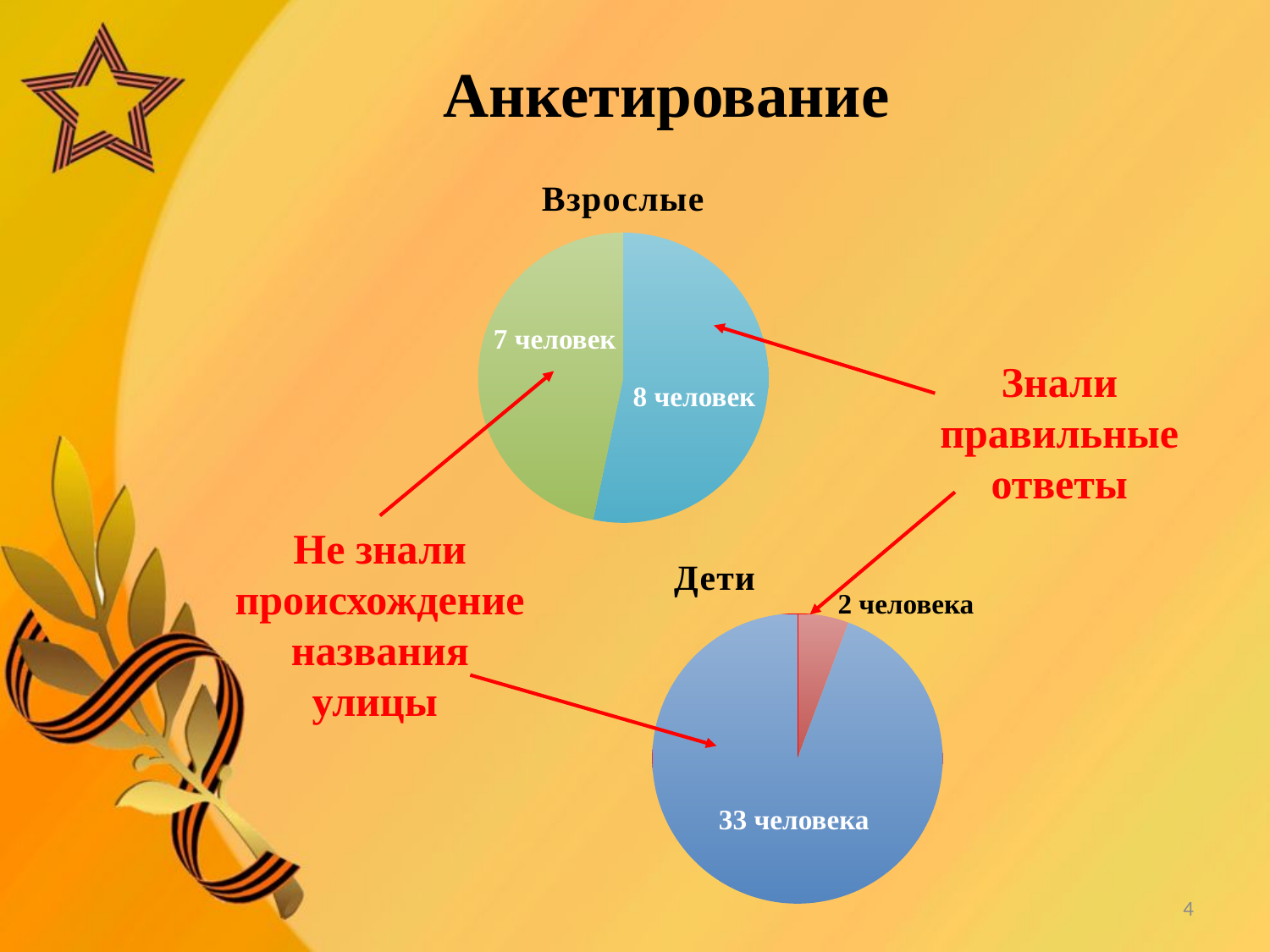
In the "Дети" chart, what is the difference between the number who did not know and the number who knew the correct answers? 31 What is the total number of adults surveyed in the "Взрослые" chart? 15 In the "Дети" chart, what colour is the slice labelled "2 человека"? Red In the "Взрослые" chart, how many people did not know the origin of the street name (Не знали происхождение названия улицы)? 7 человек What is the total number of children surveyed in the "Дети" chart? 35 In the "Взрослые" chart, which group is larger: those who knew the correct answers or those who did not know? Those who knew the correct answers (8 человек) In the "Дети" chart, how many children did not know the origin of the street name? 33 человека In the "Дети" chart, how many children knew the correct answers? 2 человека In the "Дети" chart, which slice is the largest? 33 человека (Не знали происхождение названия улицы) What kind of chart is the "Взрослые" chart? Pie chart In the "Взрослые" chart, how many people knew the correct answers (Знали правильные ответы)? 8 человек In the "Взрослые" chart, what is the difference between the number who knew and the number who did not know? 1